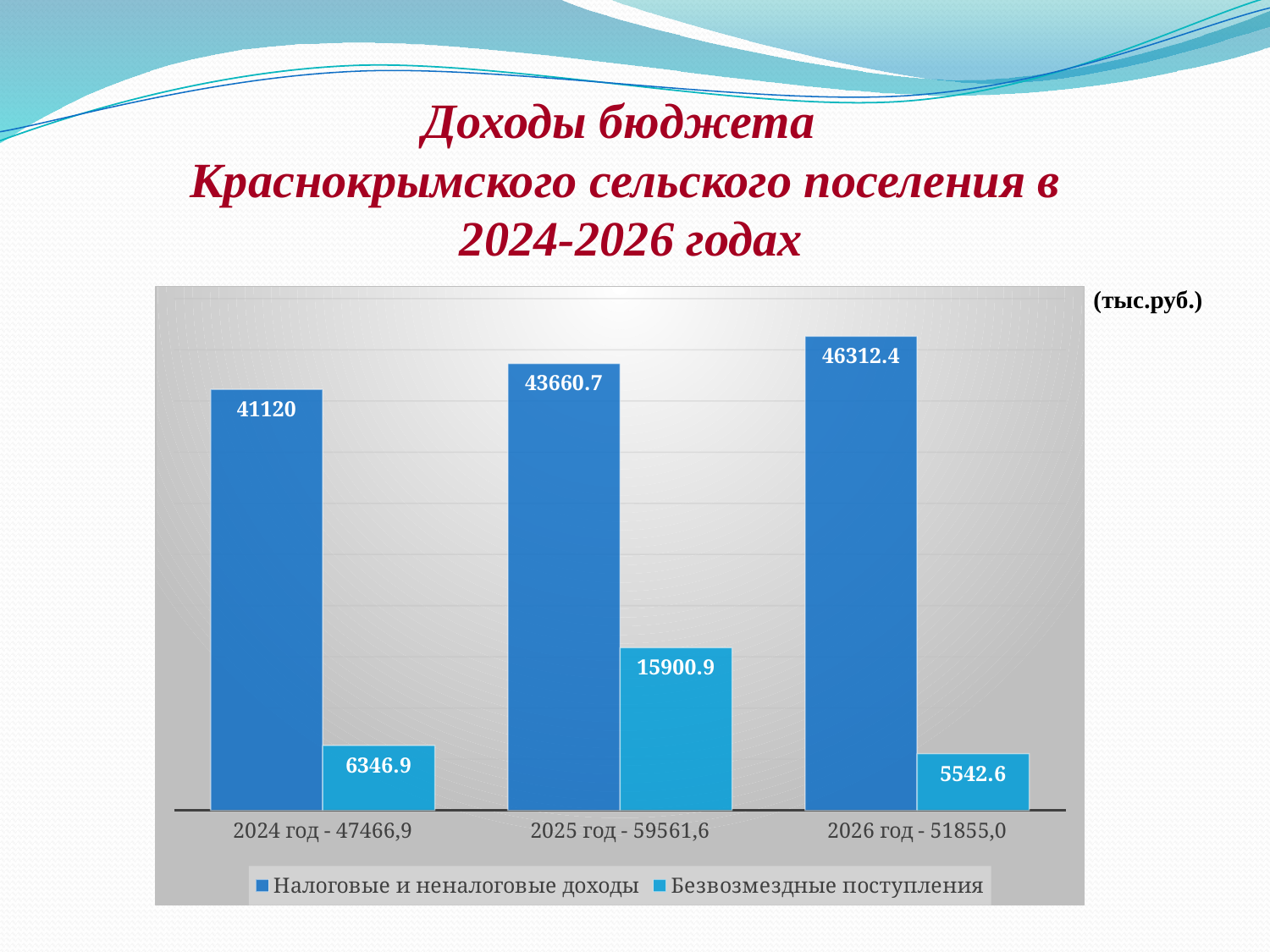
What is the difference between Безвозмездные поступления in 2025 год and 2024 год? 9554 Do the values of Налоговые и неналоговые доходы rise or fall from 2024 год to 2026 год? Rise In which year is Безвозмездные поступления the lowest? 2026 год How many years (categories) are shown on the x axis? 3 What is the value of Безвозмездные поступления for 2026 год? 5542.6 How many series does the legend list? 2 What kind of chart is shown on the slide? Bar chart What is the value of Безвозмездные поступления for 2025 год? 15900.9 In which year is Налоговые и неналоговые доходы the highest? 2026 год What is the value of Налоговые и неналоговые доходы for 2024 год? 41120 What is the difference between Налоговые и неналоговые доходы in 2025 год and 2024 год? 2540.7 Which is larger: Безвозмездные поступления in 2024 год or in 2026 год? 2024 год